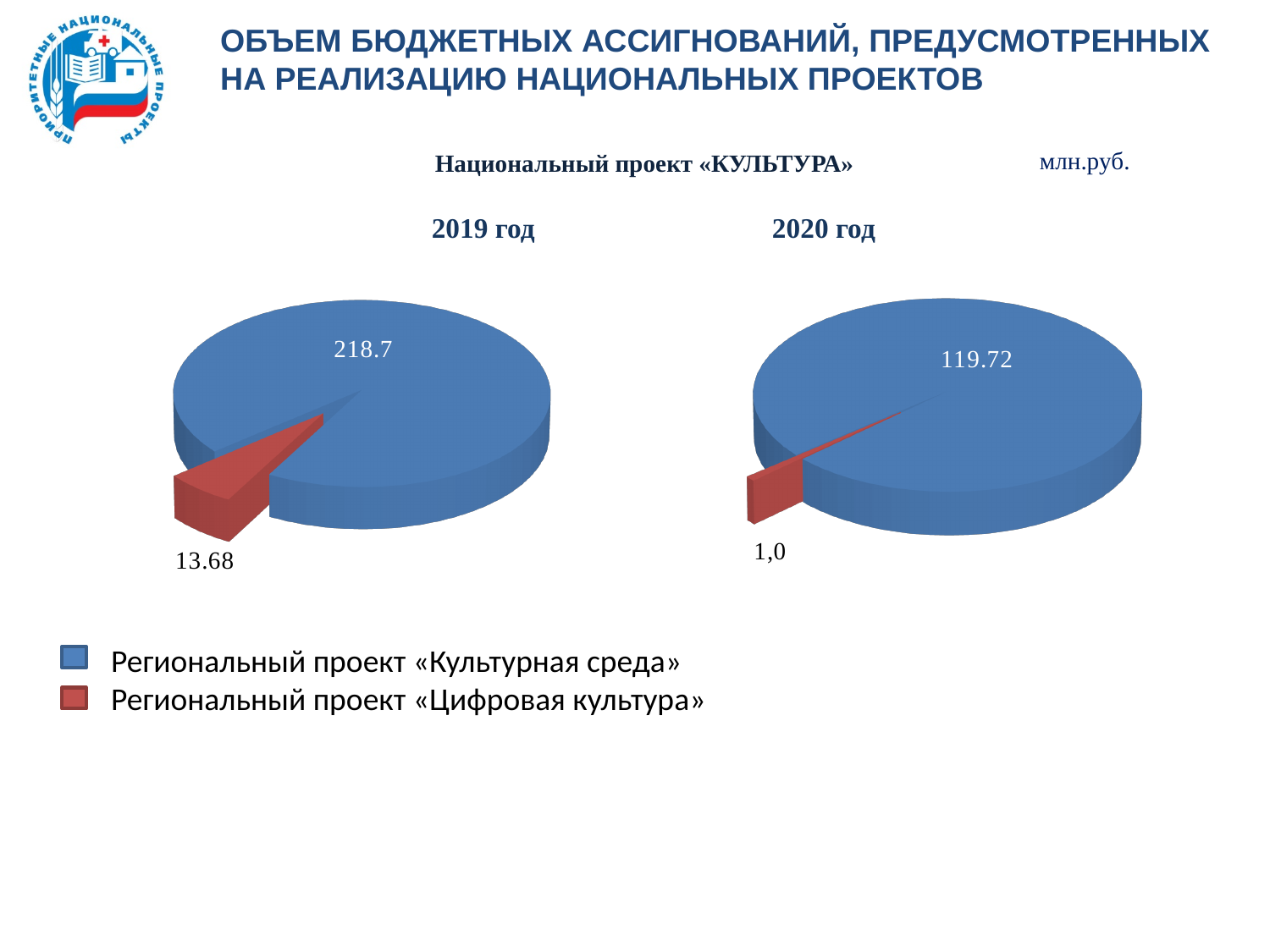
In the 2019 год pie chart, what is the difference between the values for «Культурная среда» and «Цифровая культура»? 205.02 In the 2020 год pie chart, what is the value for Региональный проект «Культурная среда»? 119.72 How many slices does the 2020 год pie chart have? 2 In the 2020 год pie chart, which project has the smallest slice? Региональный проект «Цифровая культура» What type of chart is used to show the 2019 год and 2020 год data? Pie chart In the 2019 год pie chart, what is the value for Региональный проект «Цифровая культура»? 13.68 In the 2020 год pie chart, what is the value for Региональный проект «Цифровая культура»? 1,0 What unit of measurement is shown for the values on the slide? млн.руб. In the 2019 год pie chart, which project has the largest slice? Региональный проект «Культурная среда» In the 2020 год pie chart, what is the difference between the values for «Культурная среда» and «Цифровая культура»? 118.72 In the 2019 год pie chart, what is the value for Региональный проект «Культурная среда»? 218.7 Is the value for «Культурная среда» larger in the 2019 год chart or the 2020 год chart? 2019 год